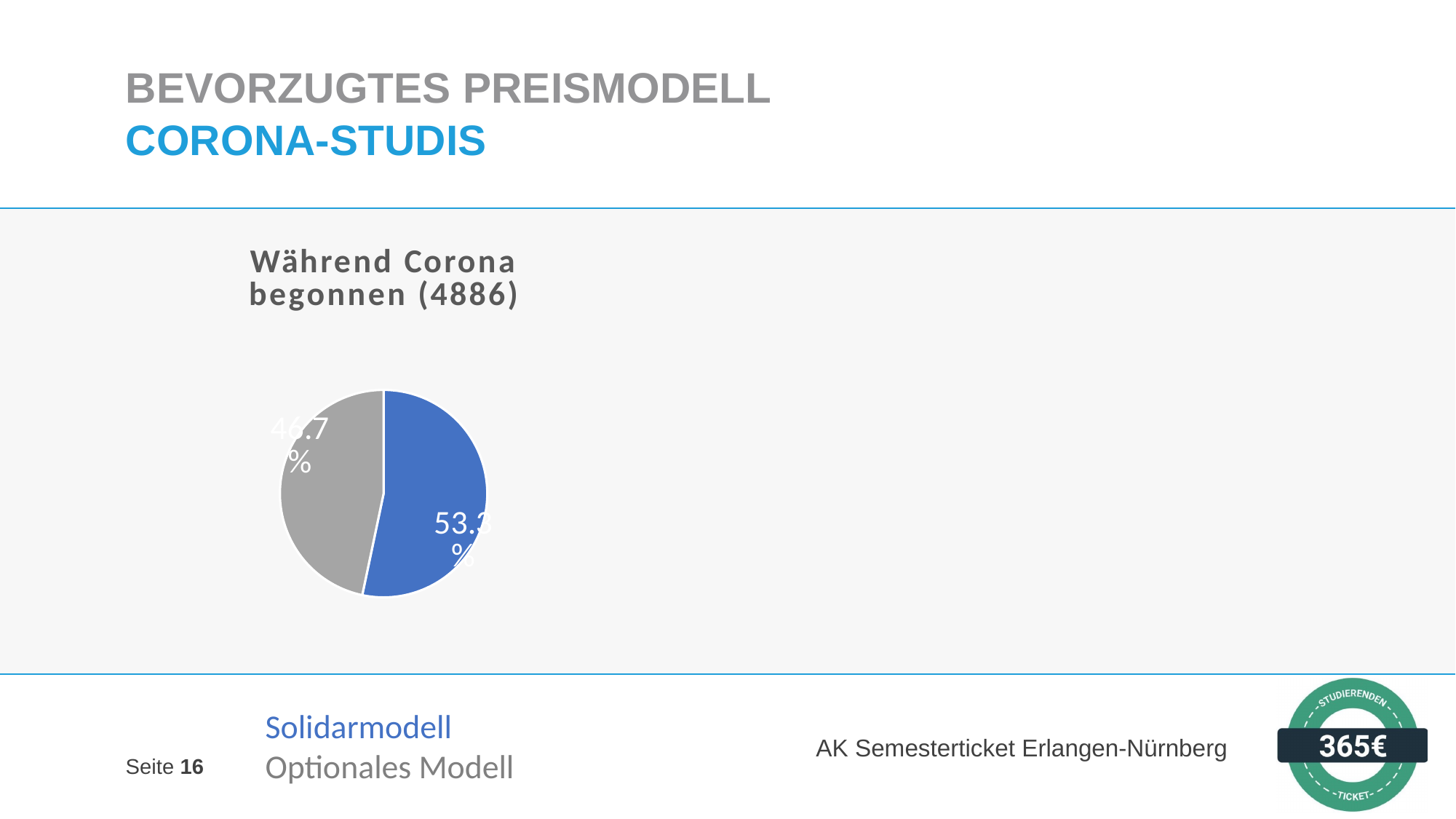
How many slices does the pie chart have? 2 Which colour represents Optionales Modell in the pie chart? grey Which is larger, the share for Solidarmodell or for Optionales Modell? Solidarmodell What is the title of the pie chart? Während Corona begonnen (4886) Which slice of the pie is the smallest? Optionales Modell What share of the pie does Optionales Modell have? 46.7% What is the difference in percentage points between the Solidarmodell and Optionales Modell slices? 6.6 What share of the pie does Solidarmodell have? 53.3% How many respondents does the chart title indicate for the group that began during Corona? 4886 What kind of chart is shown on the slide? pie chart Which slice of the pie is the largest? Solidarmodell